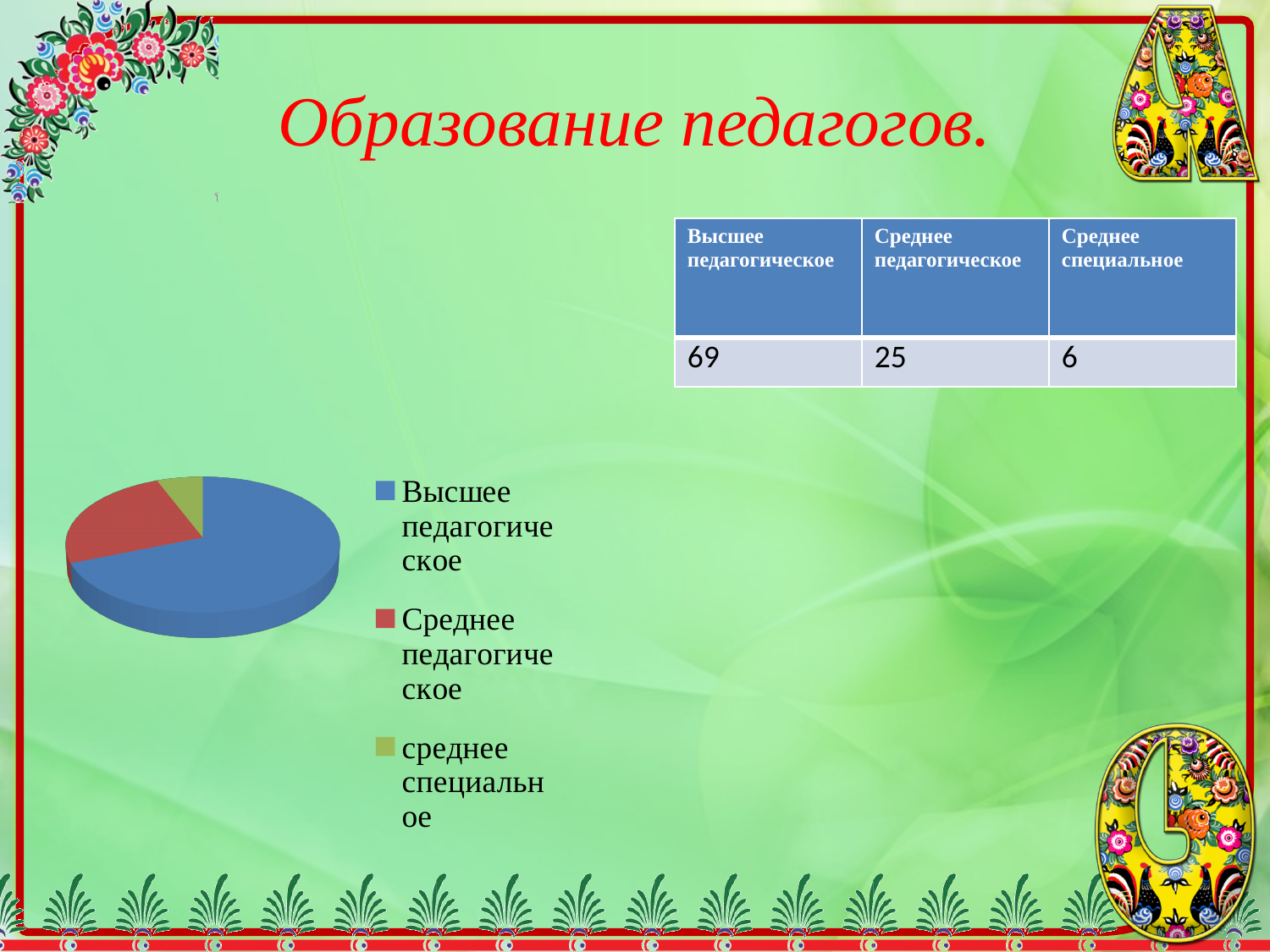
What colour is the slice for Высшее педагогическое in the pie chart? blue According to the table on the slide, what is the value for Высшее педагогическое? 69 Which category has the largest slice of the pie chart? Высшее педагогическое How many slices does the pie chart have? 3 According to the table on the slide, what is the value for Среднее педагогическое? 25 What is the title of the slide containing the pie chart? Образование педагогов. Which category has the smallest slice of the pie chart? среднее специальное How many entries does the legend of the pie chart list? 3 According to the table on the slide, what is the value for Среднее специальное? 6 What is the difference between the values for Высшее педагогическое and Среднее педагогическое shown in the table? 44 What kind of chart is shown on the slide? pie chart Which is larger, the slice for Среднее педагогическое or the slice for среднее специальное? Среднее педагогическое